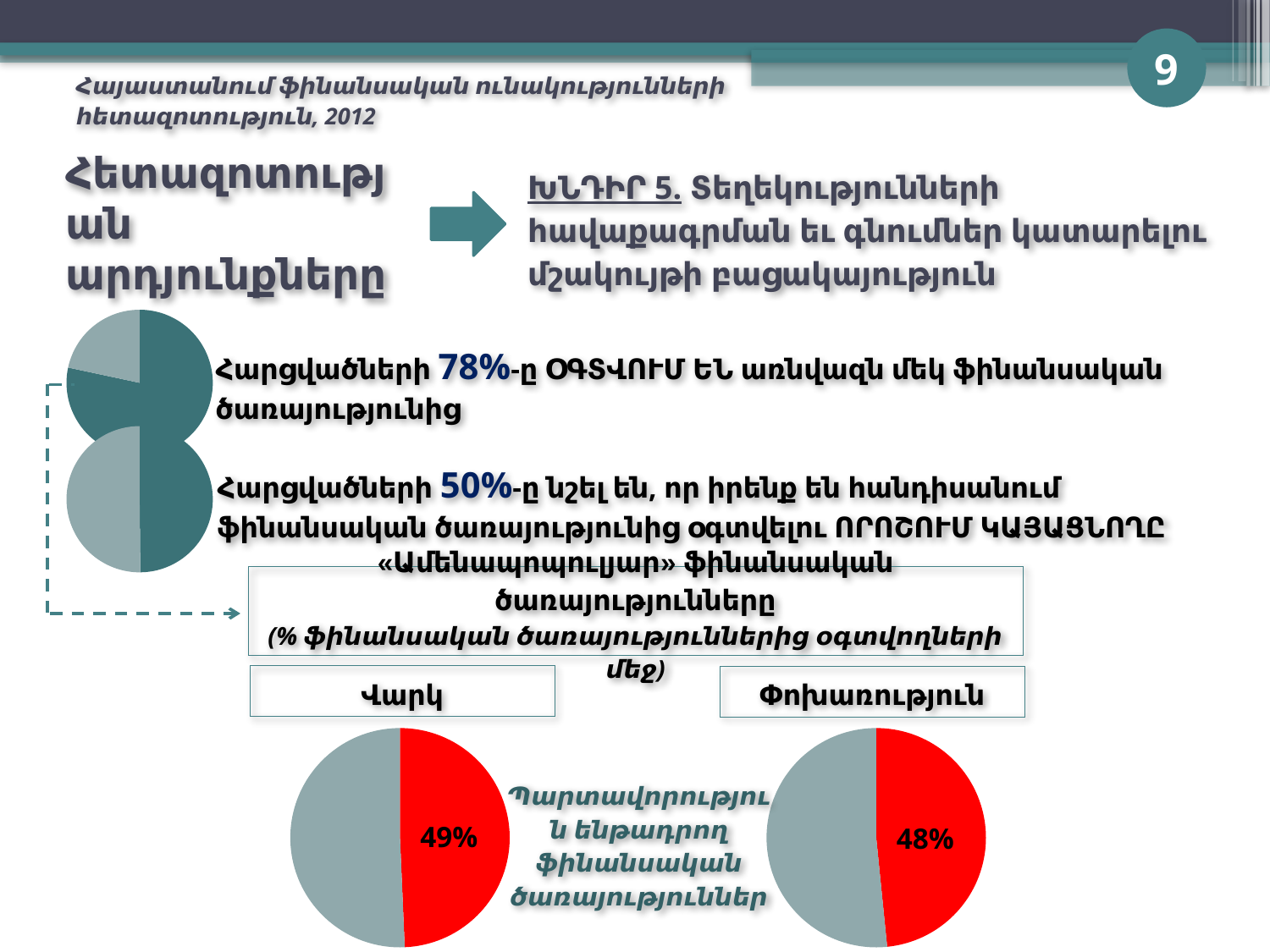
In the pie chart titled "Վարկ", is the labelled red slice greater or less than 50%? less How many pie charts are shown at the bottom of the slide under the heading "«Ամենապոպուլյար» ֆինանսական ծառայությունները"? 2 In the pie chart titled "Փոխառություն", what value is shown on the red slice? 48% Which pie chart has the larger labelled red slice, "Վարկ" or "Փոխառություն"? Վարկ What is the difference between the labelled value in the "Վարկ" pie chart and the labelled value in the "Փոխառություն" pie chart? 1% What kind of chart is the one titled "Վարկ"? pie chart What colour is the labelled slice in the pie chart titled "Վարկ"? red What share of the pie chart titled "Փոխառություն" does the red slice represent? 48% How many slices does the pie chart titled "Վարկ" have? 2 How many slices does the pie chart titled "Փոխառություն" have? 2 In the pie chart titled "Վարկ", what value is shown on the red slice? 49% What kind of chart is the one titled "Փոխառություն"? pie chart